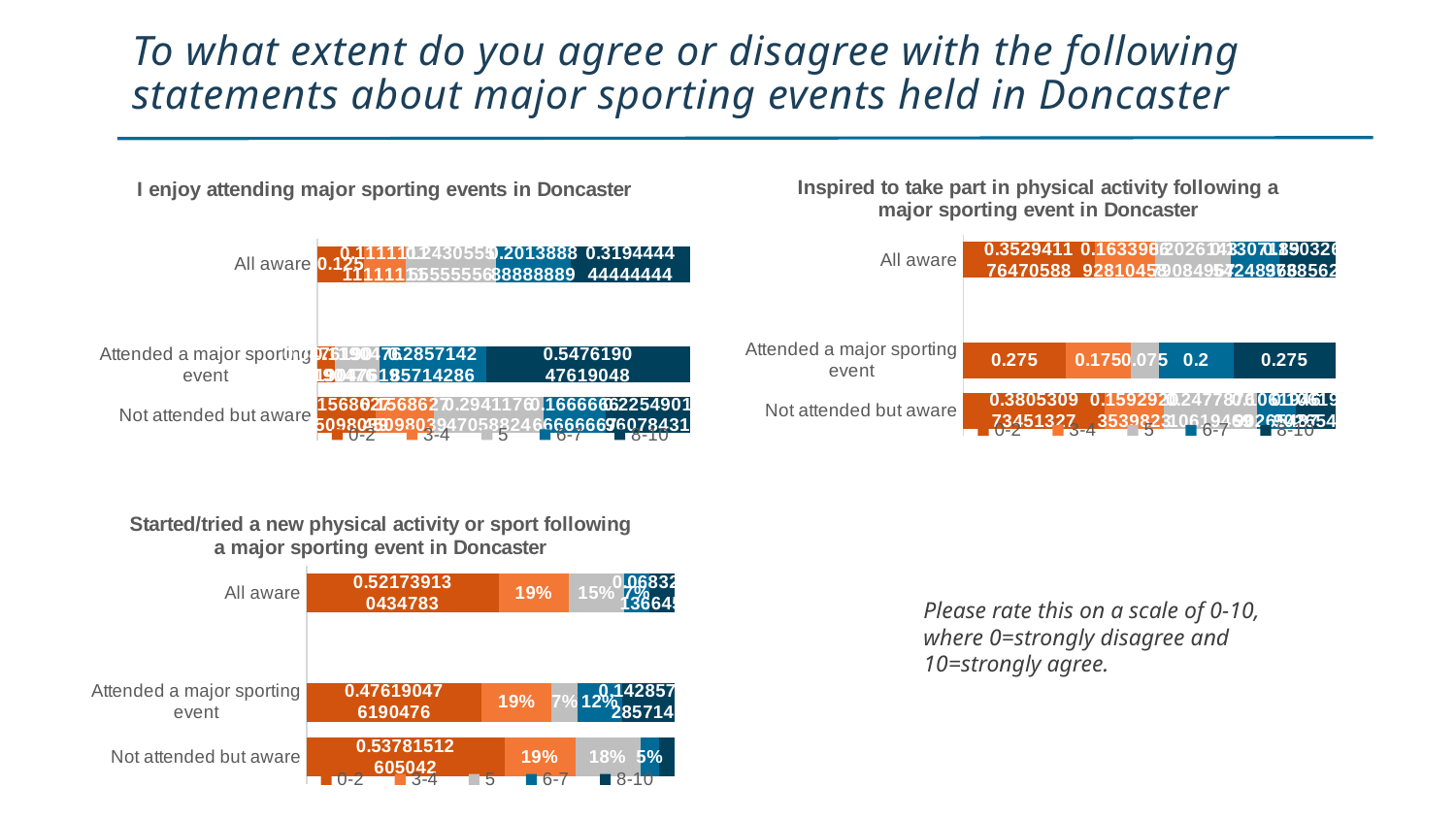
In the chart titled 'Inspired to take part in physical activity following a major sporting event in Doncaster', what is the value of the 5 segment for 'Attended a major sporting event'? 0.075 How many categories are shown in the chart titled 'I enjoy attending major sporting events in Doncaster'? 3 In the chart titled 'Started/tried a new physical activity or sport following a major sporting event in Doncaster', what is the value of the 6-7 segment for 'Attended a major sporting event'? 12% In the chart titled 'Inspired to take part in physical activity following a major sporting event in Doncaster', what is the value of the 6-7 segment for 'Attended a major sporting event'? 0.2 In the chart titled 'Started/tried a new physical activity or sport following a major sporting event in Doncaster', what is the difference between the 3-4 and 6-7 segments for 'Not attended but aware'? 14% In the chart titled 'Inspired to take part in physical activity following a major sporting event in Doncaster', what is the value of the 0-2 segment for 'Attended a major sporting event'? 0.275 In the chart titled 'Inspired to take part in physical activity following a major sporting event in Doncaster', which segment is smallest in the 'Attended a major sporting event' bar? 5 What kind of chart is the chart titled 'I enjoy attending major sporting events in Doncaster'? Stacked bar chart How many series does the legend list in the chart titled 'I enjoy attending major sporting events in Doncaster'? 5 In the chart titled 'Started/tried a new physical activity or sport following a major sporting event in Doncaster', which is larger for 'Not attended but aware': the 5 segment or the 6-7 segment? 5 In the chart titled 'Started/tried a new physical activity or sport following a major sporting event in Doncaster', what is the value of the 5 segment for 'Not attended but aware'? 18% In the chart titled 'Inspired to take part in physical activity following a major sporting event in Doncaster', what is the difference between the 0-2 and 5 segments for 'Attended a major sporting event'? 0.2